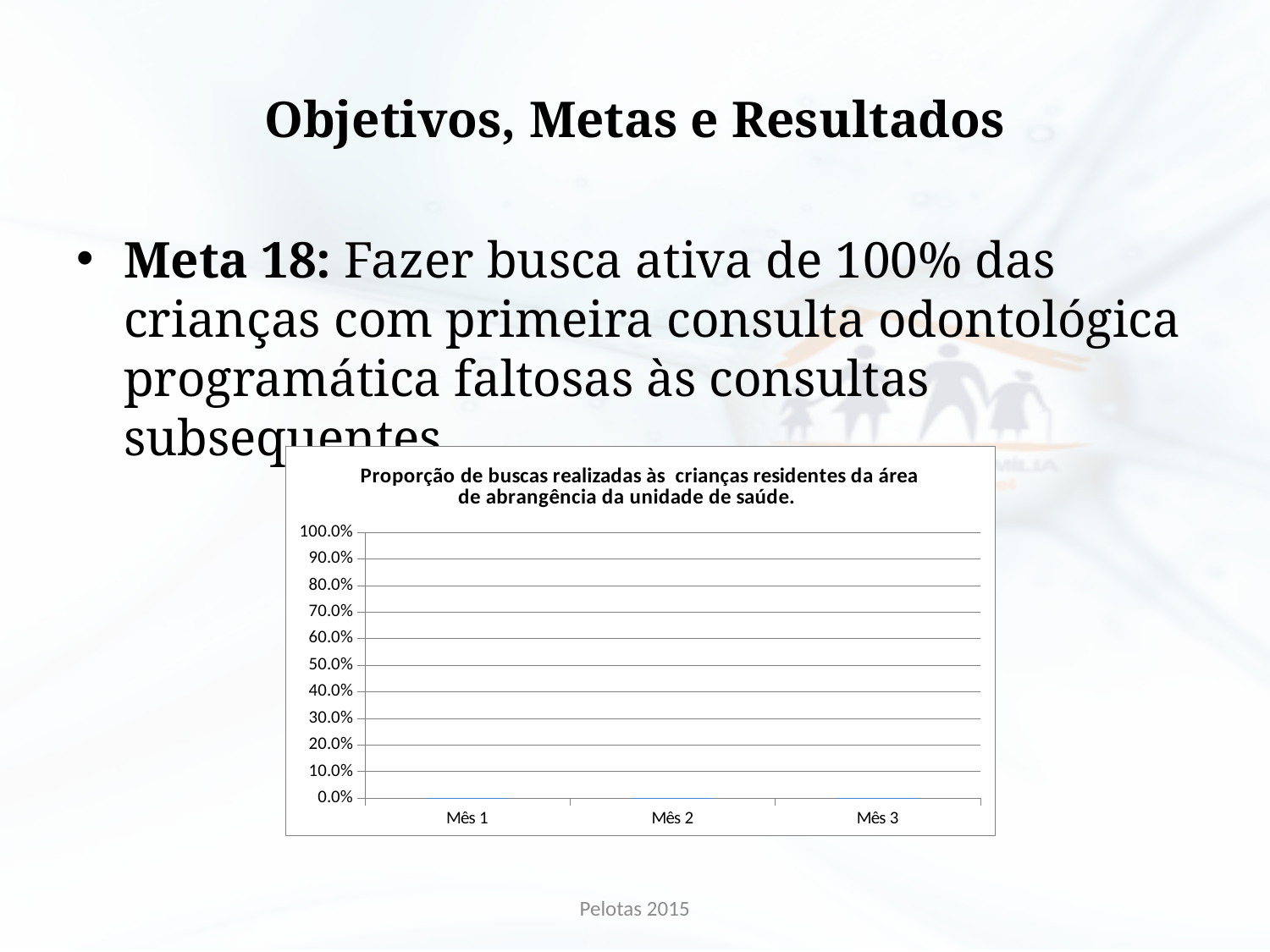
What is the label of the first category on the x axis of the chart? Mês 1 What is the title of the chart? Proporção de buscas realizadas às crianças residentes da área de abrangência da unidade de saúde. What is the highest value shown on the y axis of the chart? 100.0% What is the lowest value shown on the y axis of the chart? 0.0% How many categories are shown on the x axis of the chart? 3